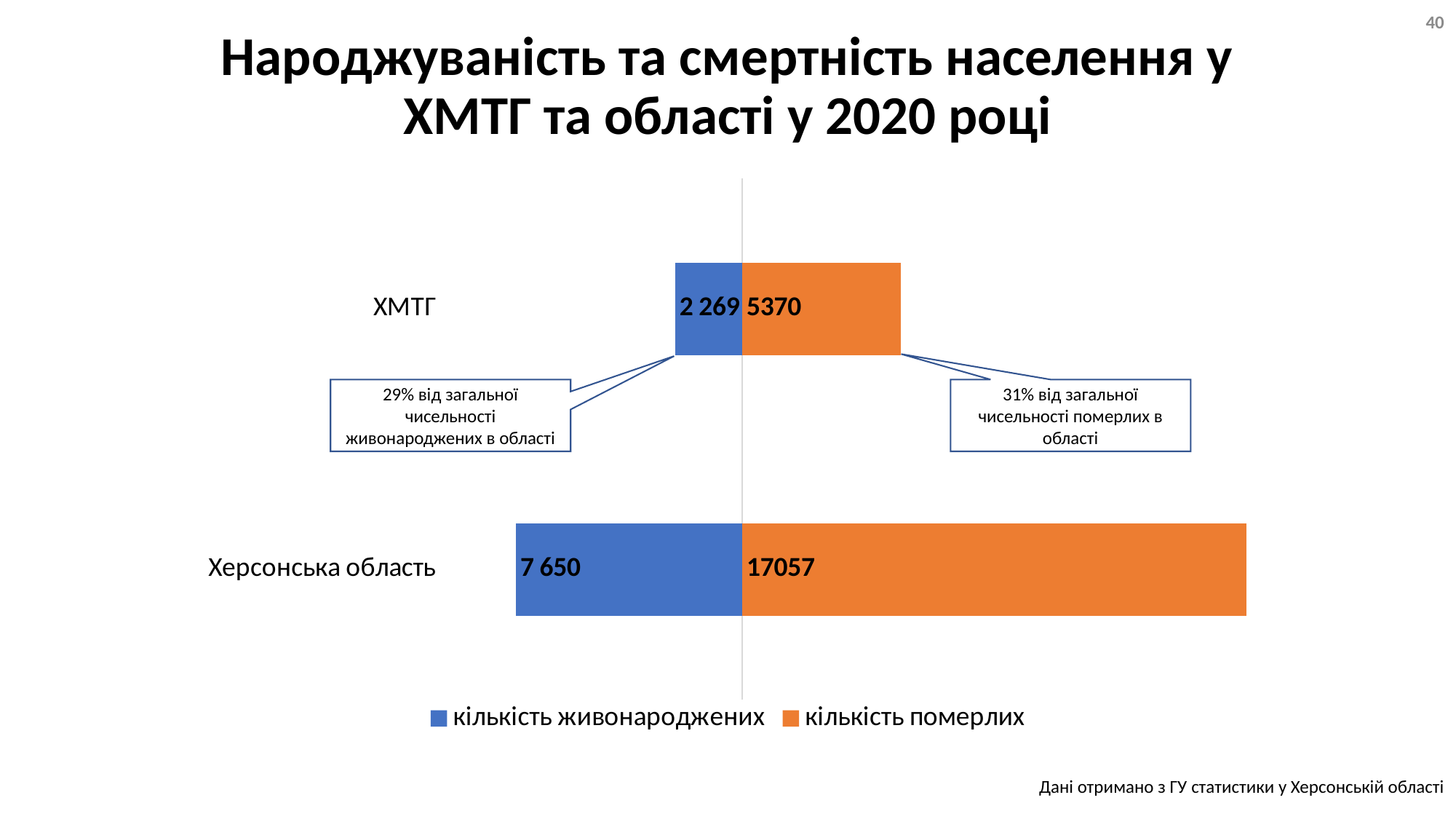
How many series does the legend list? 2 What is the number of deaths (кількість померлих) for Херсонська область? 17057 What is the number of live births (кількість живонароджених) for ХМТГ? 2 269 How many categories are shown on the chart? 2 What is the difference between the number of live births in Херсонська область and in ХМТГ? 5381 What is the number of live births (кількість живонароджених) for Херсонська область? 7 650 What is the number of deaths (кількість померлих) for ХМТГ? 5370 What is the difference between the number of deaths and the number of live births in ХМТГ? 3101 For Херсонська область, which is larger: the number of live births or the number of deaths? кількість померлих Which category has the higher number of deaths (кількість померлих)? Херсонська область What type of chart is shown on the slide? bar chart Which category has the lower number of live births (кількість живонароджених)? ХМТГ